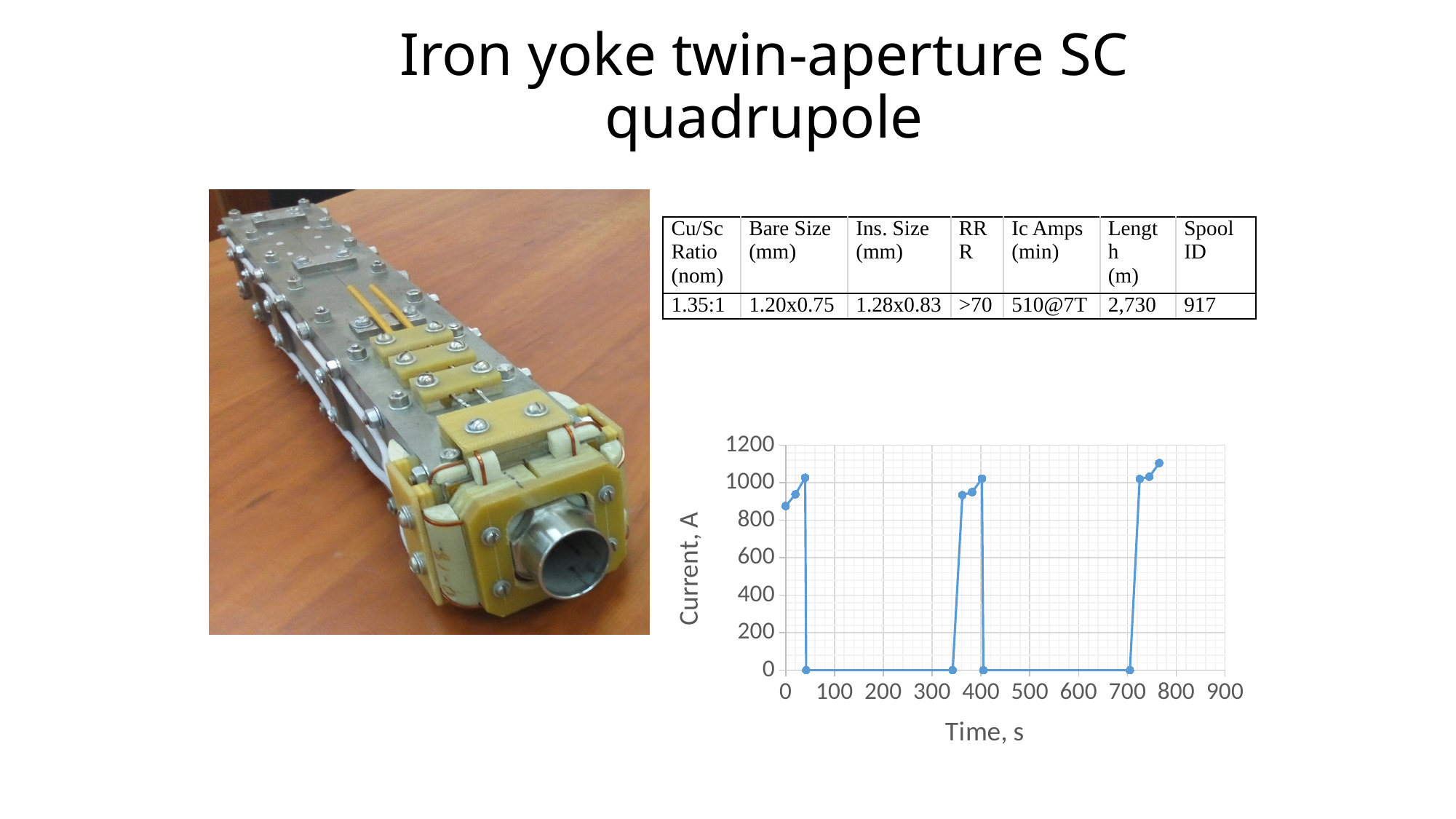
Is the highest current reached in the chart greater or less than 1000 A? greater What is the label of the x axis of the chart? Time, s What is the highest value shown on the y axis of the chart? 1200 Is the current at time 0 s greater or less than 800 A? greater Is the current at time 200 s greater or less than 200 A? less Which is larger: the peak current reached near 40 s or the peak current reached near 760 s? near 760 s What kind of chart is shown on the slide? line chart What is the label of the y axis of the chart? Current, A Between about 700 s and 760 s, does the current rise or fall? rise